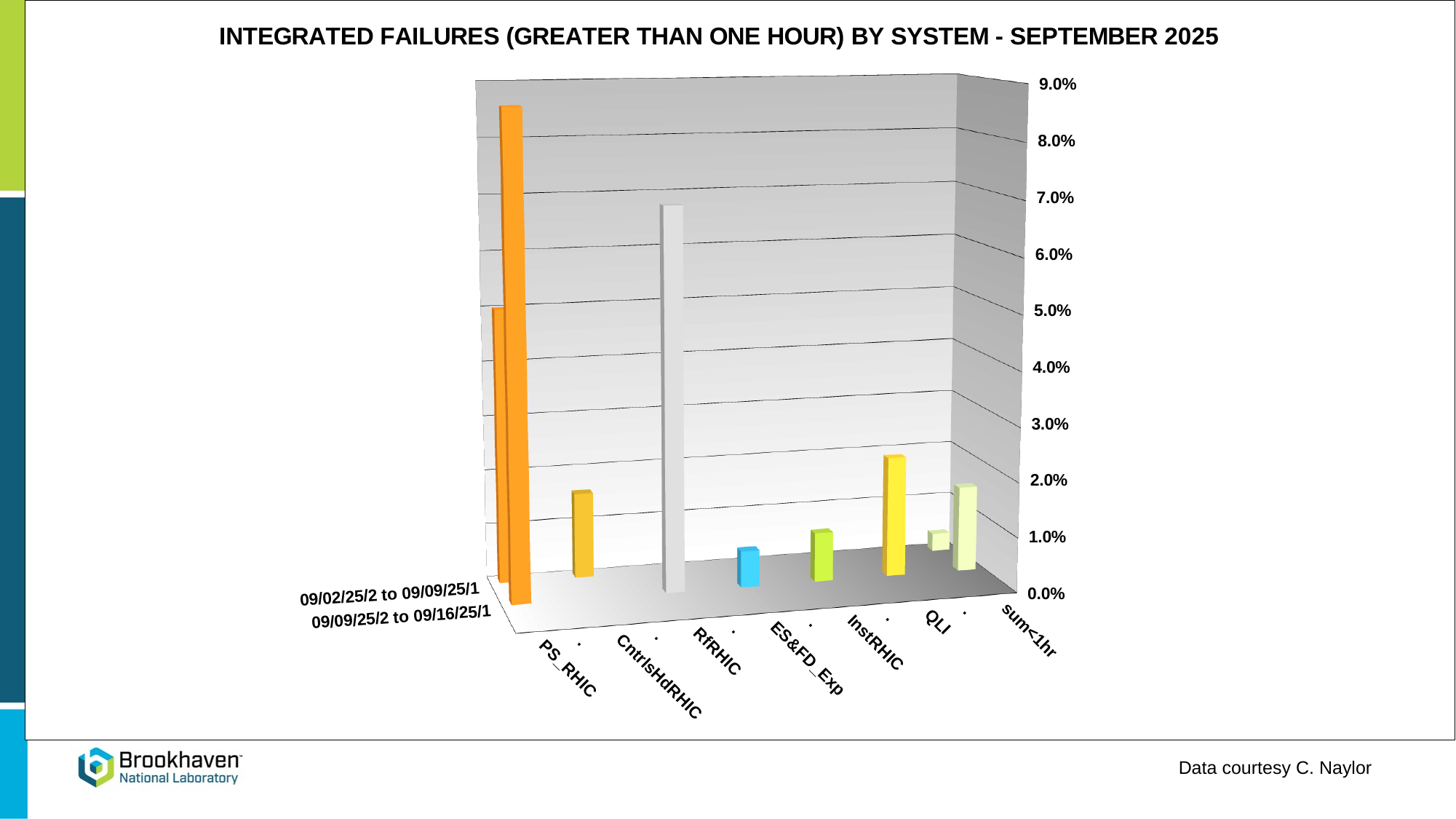
How many date-range series does the chart show? 2 Is the tallest bar for RfRHIC greater or less than 6.0%? greater Which has a taller bar, QLI or ES&FD_Exp? QLI Is the tallest bar for QLI greater or less than 3.0%? less Which has a taller bar, CntrlsHdRHIC or RfRHIC? RfRHIC What type of chart is shown on the slide? bar chart Which system has the tallest bar in the chart? PS_RHIC Is the tallest bar for PS_RHIC greater or less than 8.0%? greater Which has a taller bar, PS_RHIC or RfRHIC? PS_RHIC What is the maximum value shown on the vertical axis of the chart? 9.0% What is the title of the chart? INTEGRATED FAILURES (GREATER THAN ONE HOUR) BY SYSTEM - SEPTEMBER 2025 How many system categories are shown along the x axis of the chart? 7